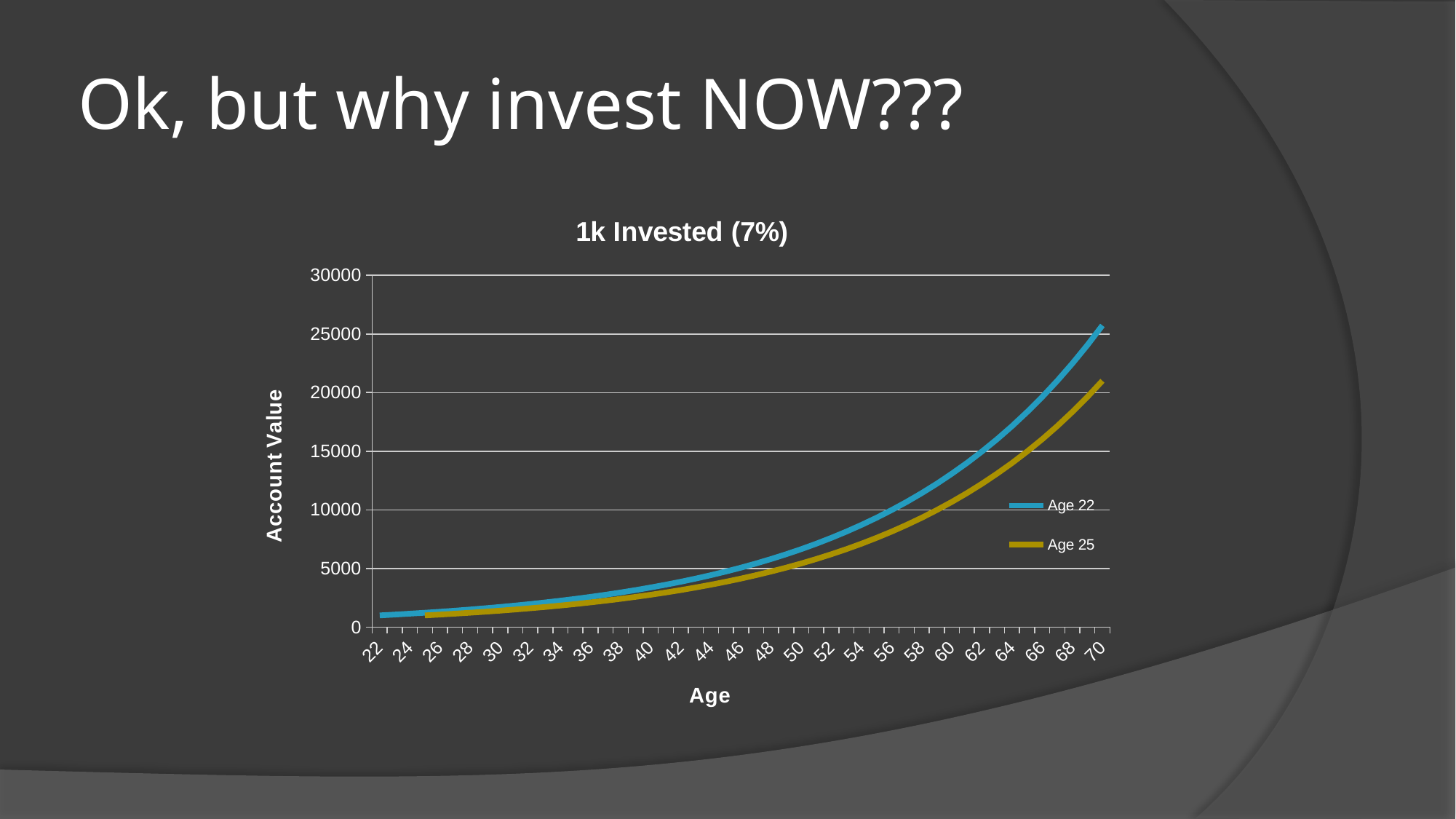
What is the title of the chart? 1k Invested (7%) Is the value for the Age 22 series at age 50 greater or less than 5000? greater Which series has the higher account value at age 70, Age 22 or Age 25? Age 22 Is the value for the Age 25 series at age 40 greater or less than 5000? less Is the value for the Age 22 series at age 70 greater or less than 20000? greater How many age labels are shown on the x axis? 25 How many series does the legend list? 2 What kind of chart is shown on the slide? line chart What are the two series named in the legend? Age 22 and Age 25 Do the account values rise or fall as age increases along the x axis? rise Which series reaches the highest account value on the chart? Age 22